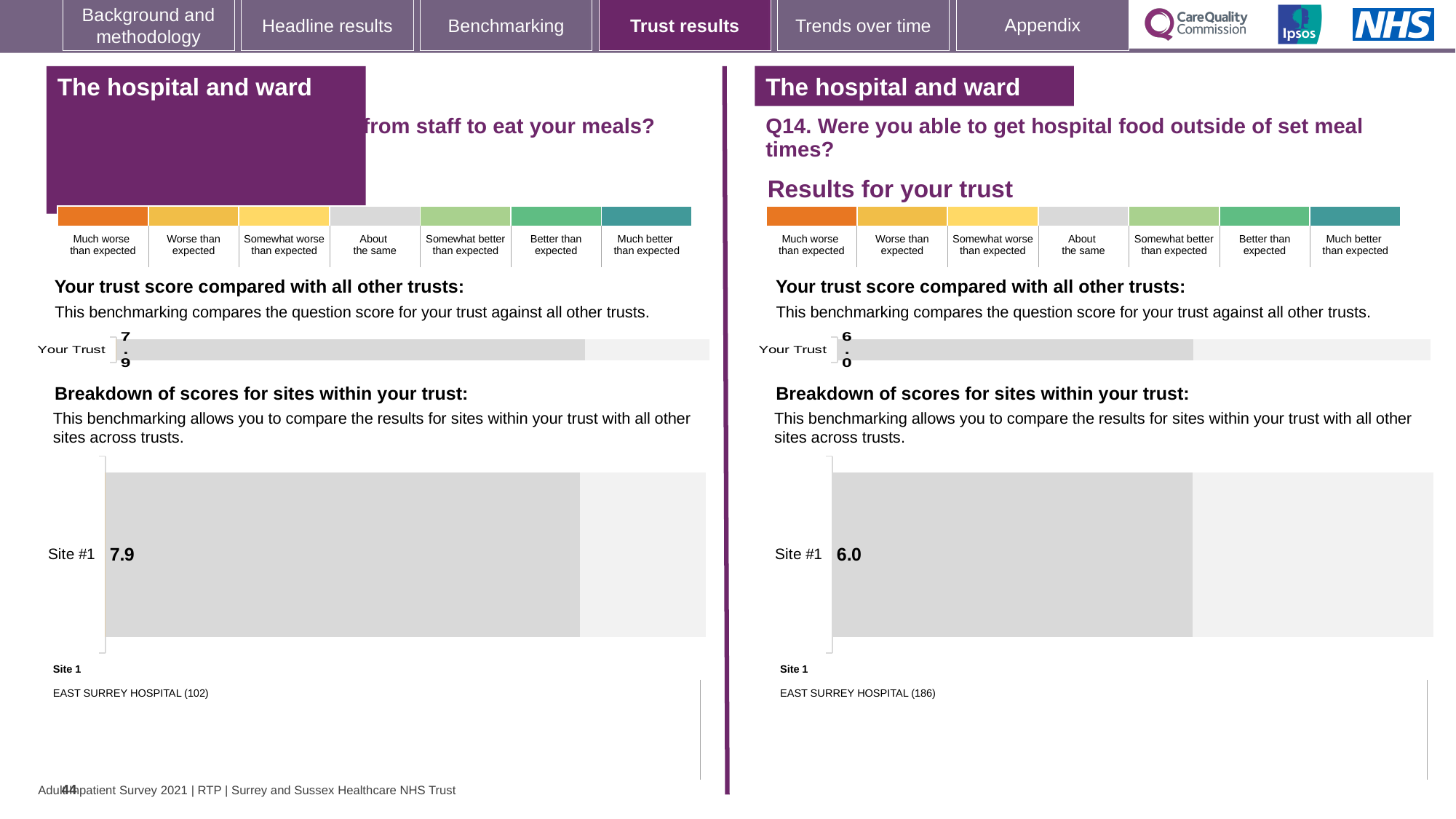
Which site is listed as Site 1 beneath the right-hand breakdown chart (Q14)? EAST SURREY HOSPITAL (186) Which site is listed as Site 1 beneath the left-hand breakdown chart? EAST SURREY HOSPITAL (102) On the right half of the slide (Q14), what is the score shown for Your Trust? 6.0 Which is larger: the Your Trust score on the left half of the slide or the Your Trust score on the right half (Q14)? the left half (7.9) What is the difference between the Site #1 score on the left half of the slide and the Site #1 score on the right half (Q14)? 1.9 On the left half of the slide, what is the score shown for Your Trust? 7.9 On the left half of the slide, is the Site #1 score greater or less than the Your Trust score, or are they equal? equal What kind of chart is used to show the Site #1 score on the right half of the slide? bar chart How many sites are shown in the left-hand 'Breakdown of scores for sites within your trust' chart? 1 Is the Your Trust score on the right half of the slide (Q14) greater or less than 7? less In the left-hand 'Breakdown of scores for sites within your trust' chart, what is the score for Site #1? 7.9 In the right-hand 'Breakdown of scores for sites within your trust' chart (Q14), what is the score for Site #1? 6.0